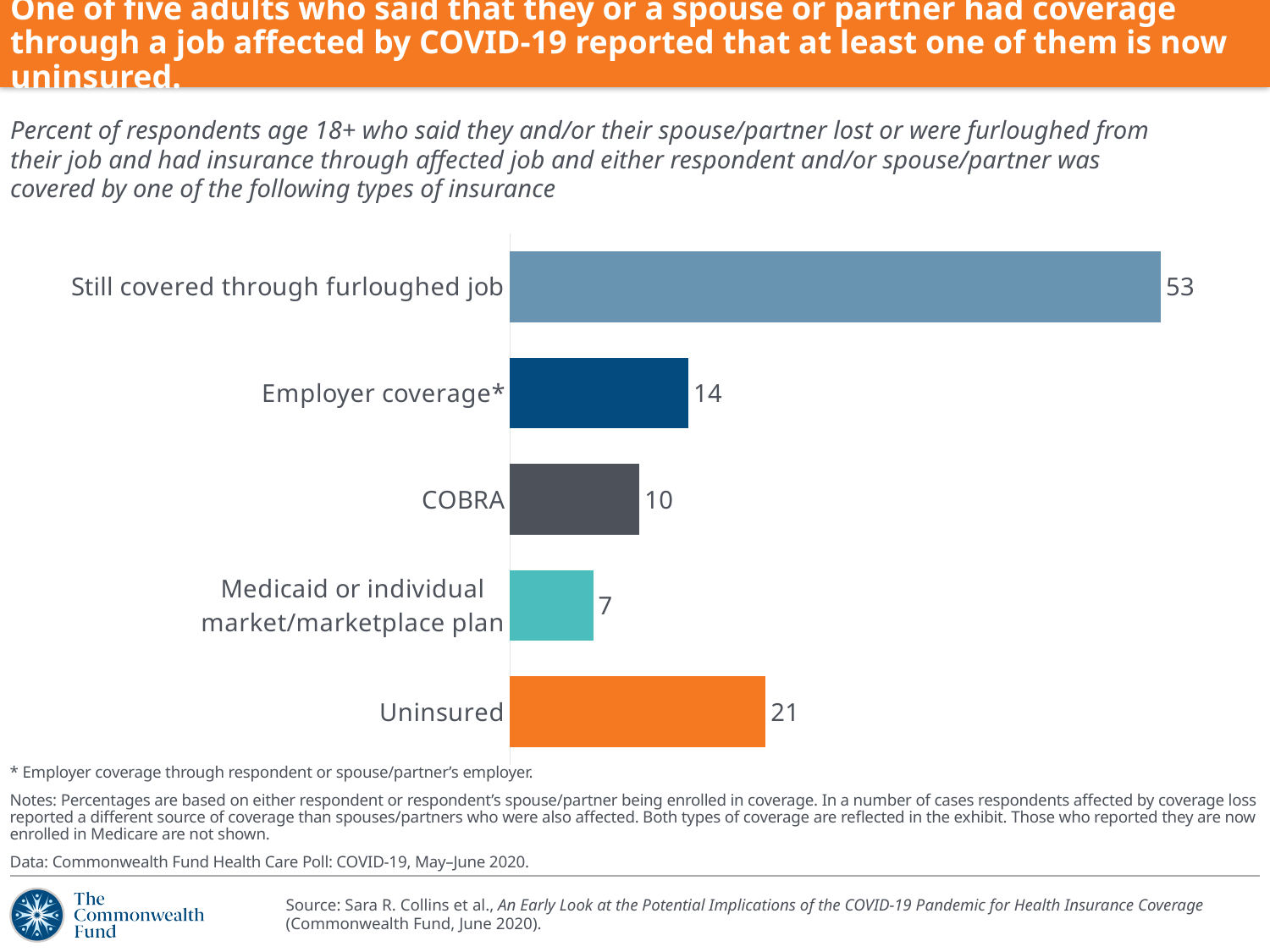
Which category has the lowest value? Medicaid or individual market/marketplace plan Which is larger, the value for Uninsured or the value for Employer coverage*? Uninsured What colour is the bar for Uninsured? Orange What is the value for Still covered through furloughed job? 53 What is the difference between the values for Still covered through furloughed job and Uninsured? 32 What kind of chart is shown on the slide? Bar chart What is the difference between the values for Employer coverage* and COBRA? 4 How many categories are shown in the chart? 5 What is the value for COBRA? 10 Which category has the highest value? Still covered through furloughed job What is the value for Medicaid or individual market/marketplace plan? 7 What is the value for Uninsured? 21